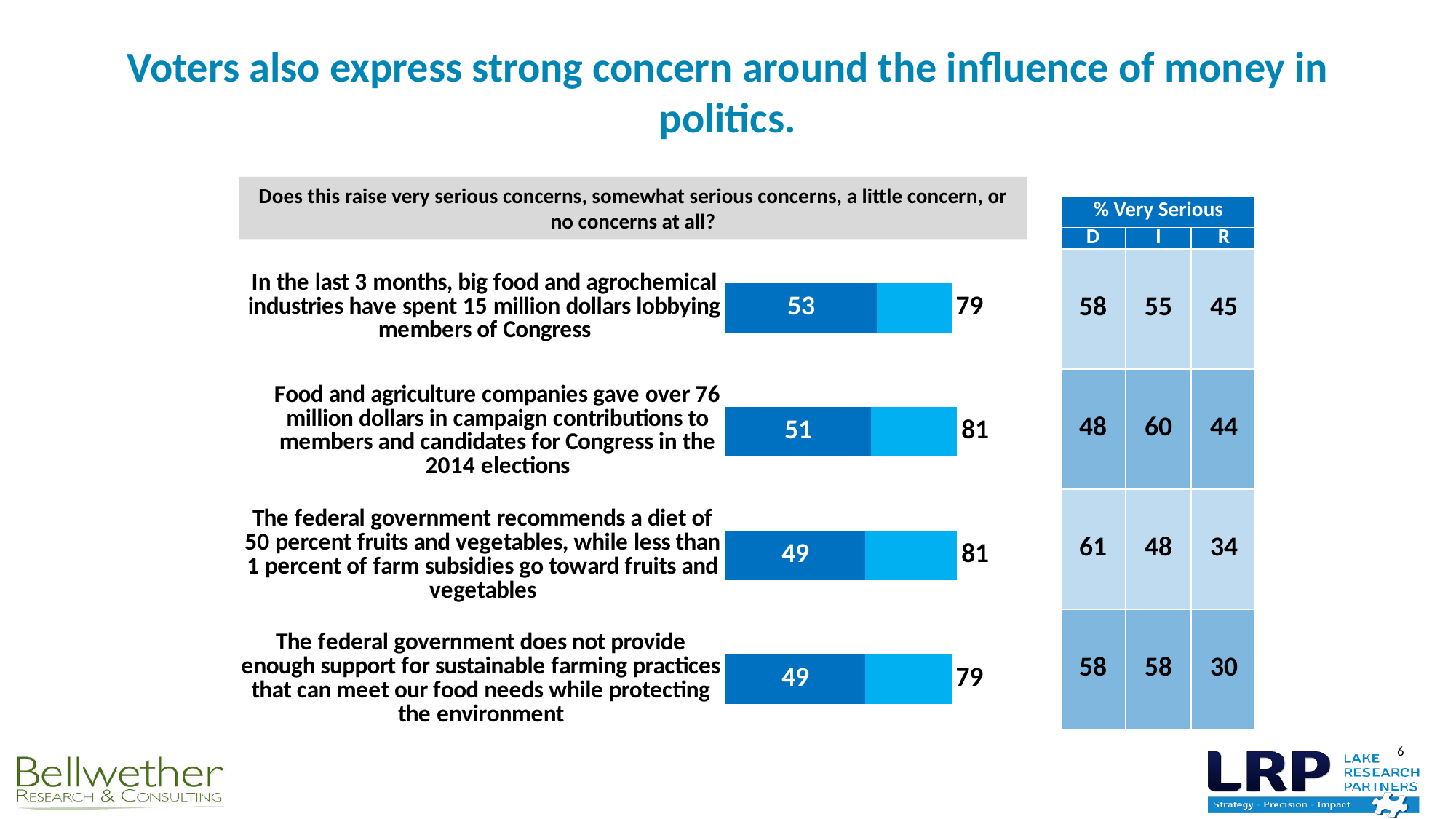
What is the dark blue (very serious) value for the statement about big food and agrochemical industries spending 15 million dollars lobbying Congress? 53 What kind of chart is shown on the slide? Bar chart How many statements (categories) are plotted in the bar chart? 4 What is the dark blue value for the statement about the federal government recommending a diet of 50 percent fruits and vegetables while less than 1 percent of farm subsidies go toward fruits and vegetables? 49 Based on the printed labels, what is the size of the light blue segment for the lobbying statement (total 79 minus dark blue 53)? 26 What survey question is shown in the grey box above the bar chart? Does this raise very serious concerns, somewhat serious concerns, a little concern, or no concerns at all? What is the difference between the total for the campaign contributions statement (81) and the total for the lobbying statement (79)? 2 Which has the larger dark blue value: the statement about lobbying members of Congress or the statement about campaign contributions in the 2014 elections? The statement about lobbying members of Congress What is the difference between the dark blue value for the lobbying statement (53) and the dark blue value for the sustainable farming practices statement (49)? 4 Which statement has the highest dark blue (very serious) value in the bar chart? In the last 3 months, big food and agrochemical industries have spent 15 million dollars lobbying members of Congress What is the total value shown for the bar about the federal government not providing enough support for sustainable farming practices? 79 What is the total value shown at the end of the bar for the statement about food and agriculture companies giving over 76 million dollars in campaign contributions? 81